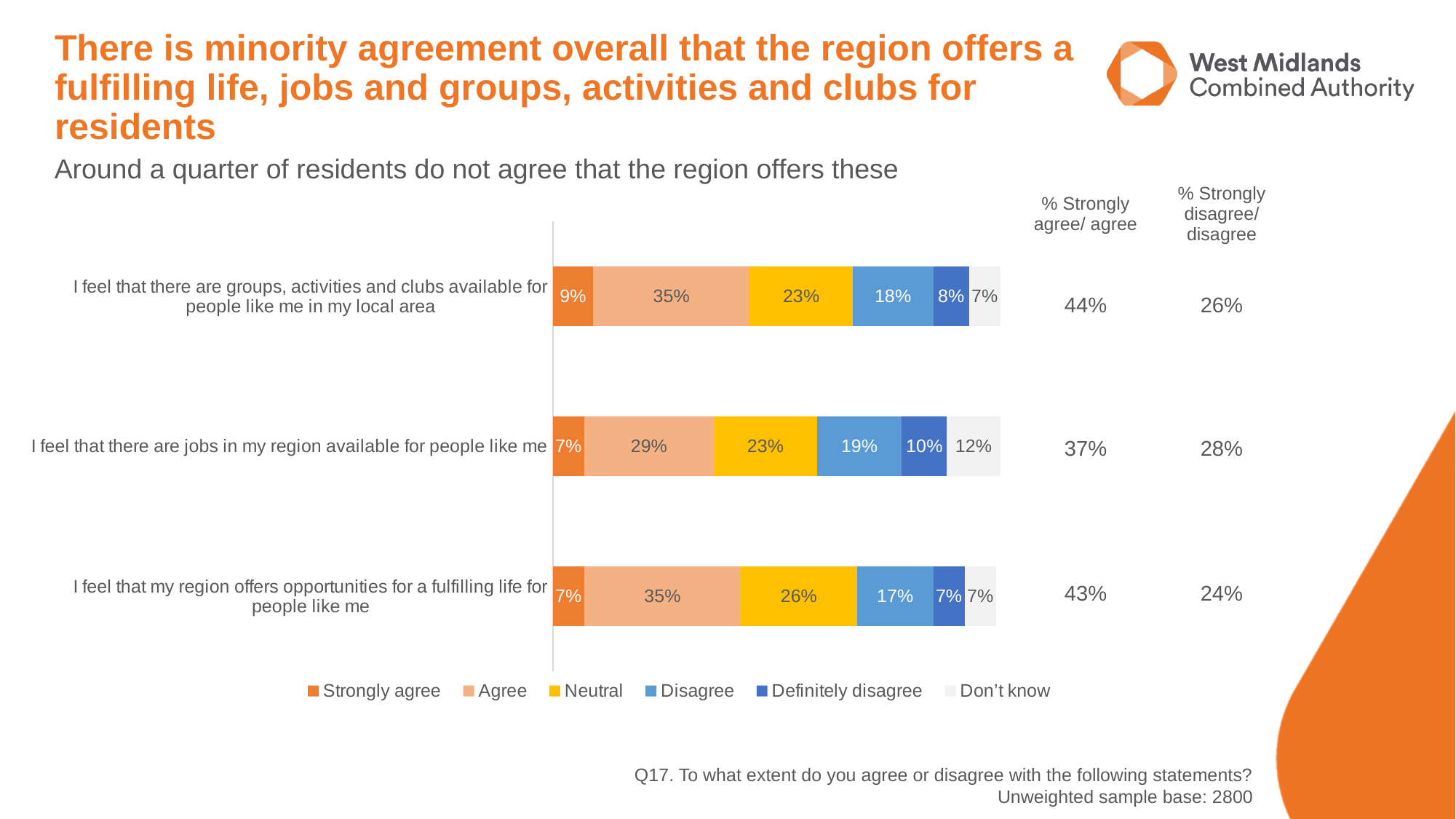
How many series does the legend list? 6 What colour represents 'Neutral' in the chart? Yellow Which statement has the highest 'Agree' percentage? Groups, activities and clubs available for people like me in my local area (35%) and my region offers opportunities for a fulfilling life (35%) are tied What percentage of residents strongly agree that there are groups, activities and clubs available for people like them in their local area? 9% What percentage of residents are neutral on the statement that their region offers opportunities for a fulfilling life? 26% How many statements are shown in the chart? 3 What kind of chart is shown on the slide? Stacked bar chart Is the 'Definitely disagree' percentage larger for the jobs statement or the fulfilling life statement? Jobs statement What is the difference between the 'Agree' percentage for the groups, activities and clubs statement and the 'Agree' percentage for the jobs statement? 6% What percentage of residents disagree that there are jobs in their region available for people like them? 19% What percentage of residents answered 'Don't know' for the statement about jobs in the region being available for people like them? 12% Which statement has the lowest 'Strongly agree' percentage? Jobs in my region and opportunities for a fulfilling life are tied at 7%